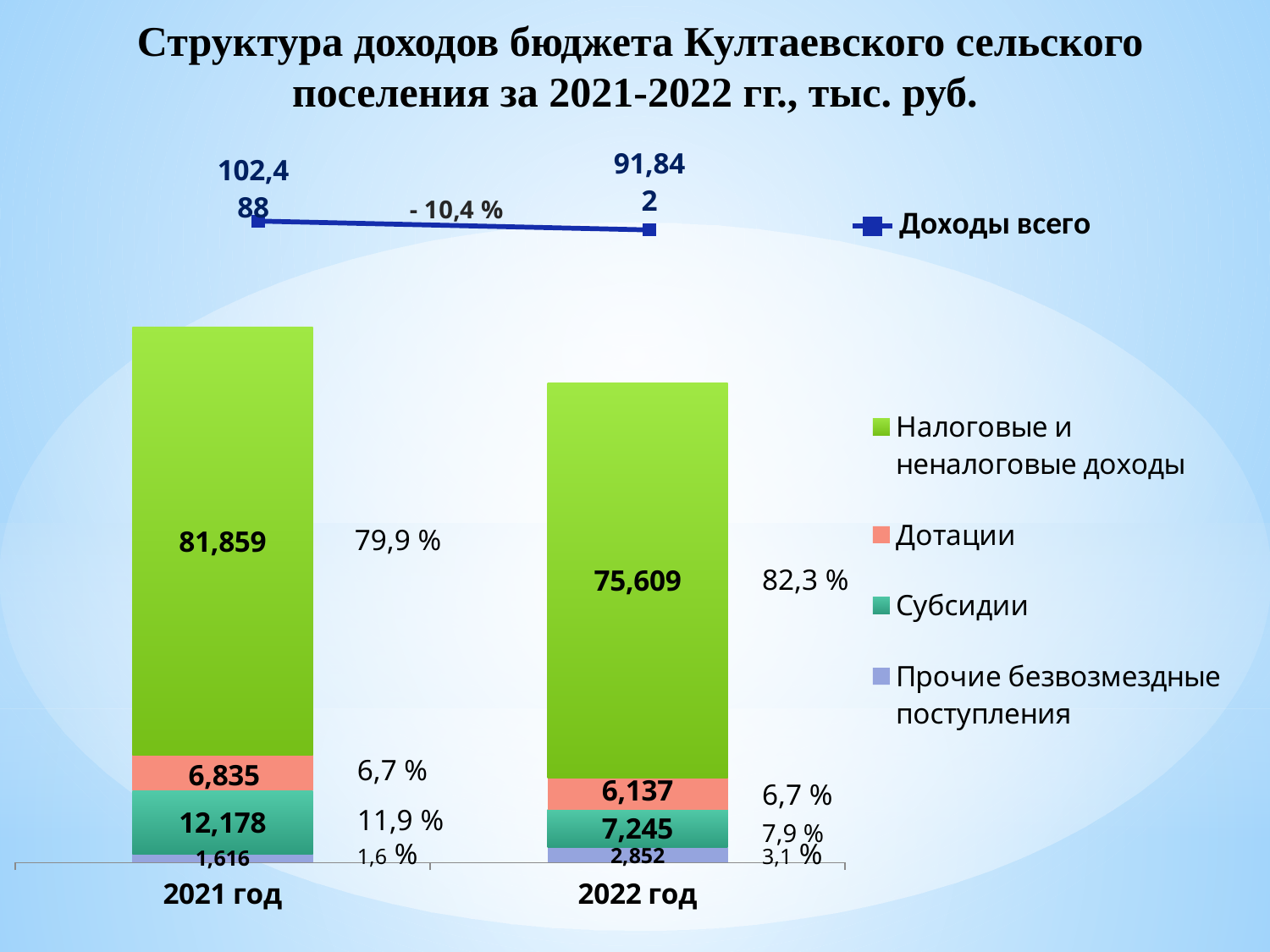
What is the total Доходы всего value shown for 2021 год? 102,488 What is the total Доходы всего value shown for 2022 год? 91,842 What is the value of Дотации for 2021 год? 6,835 What is the value of Налоговые и неналоговые доходы for 2021 год? 81,859 Is the value of Субсидии larger in 2021 год or 2022 год? 2021 год What percentage change in total income is labelled on the line between 2021 год and 2022 год? - 10,4 % Which series has the largest value in the 2022 год bar? Налоговые и неналоговые доходы Which series has the smallest value in the 2021 год bar? Прочие безвозмездные поступления What is the value of Субсидии for 2022 год? 7,245 How many entries does the legend list? 5 Does the Доходы всего line rise or fall from 2021 год to 2022 год? fall What is the value of Прочие безвозмездные поступления for 2022 год? 2,852